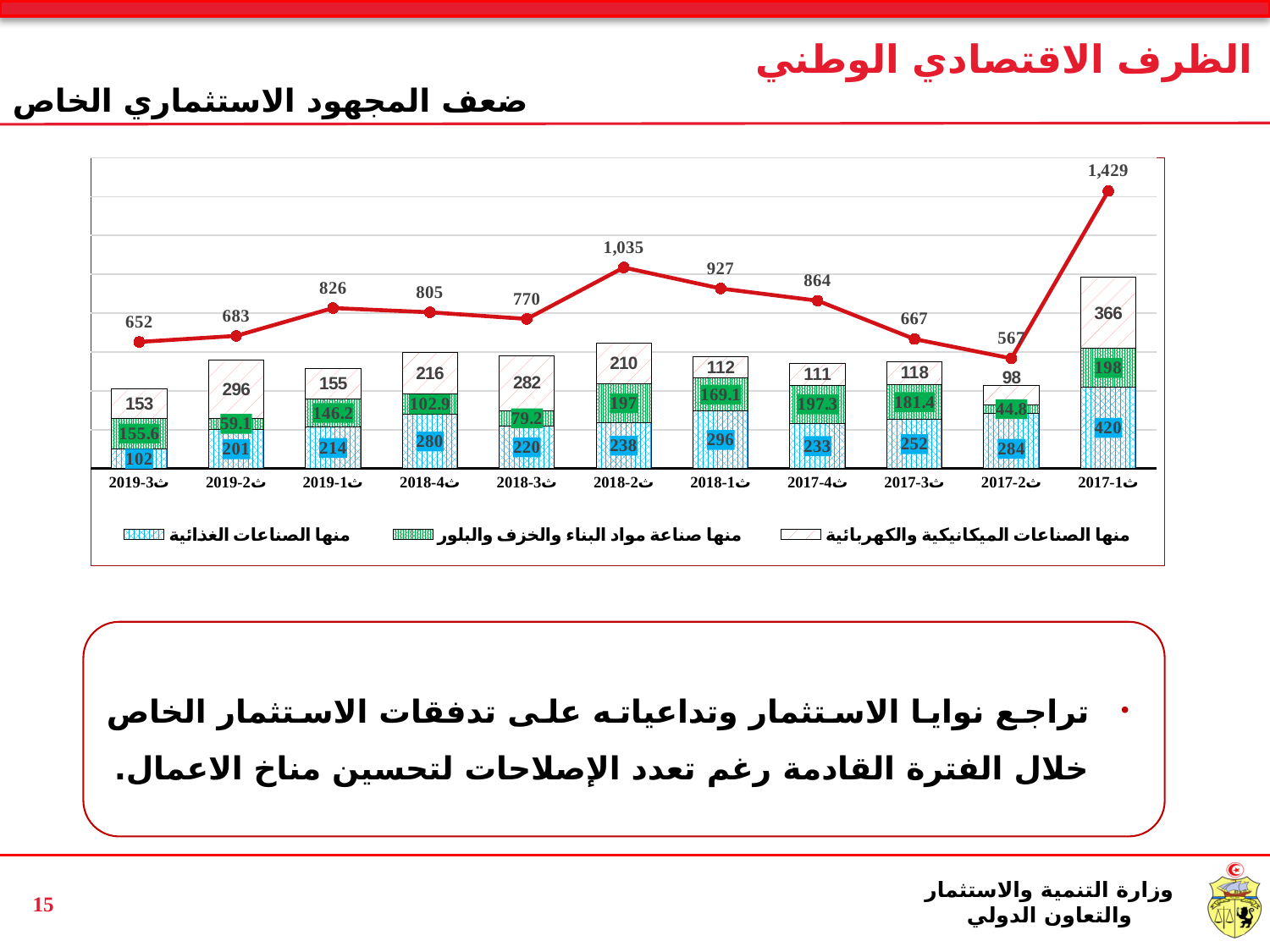
At which quarter does the red line reach its highest value? ث1-2017 What is the value of the building materials, ceramics and glass (صناعة مواد البناء والخزف والبلور) segment for ث2-2017? 44.8 What is the value of the food industries (الصناعات الغذائية) segment for ث1-2017? 420 What is the value of the mechanical and electrical industries (الصناعات الميكانيكية والكهربائية) segment for ث2-2019? 296 Which quarter has the larger red line value, ث1-2019 or ث4-2018? ث1-2019 At which quarter does the red line reach its lowest value? ث2-2017 What is the difference between the red line values at ث1-2017 and ث2-2018? 394 What is the value of the red line at ث1-2017? 1,429 What kind of chart is shown on the slide? Combined stacked bar and line chart What is the total of the stacked bar for ث1-2017? 984 Which quarter has the lowest value for the building materials, ceramics and glass segment? ث2-2017 How many quarters are shown on the x axis? 11